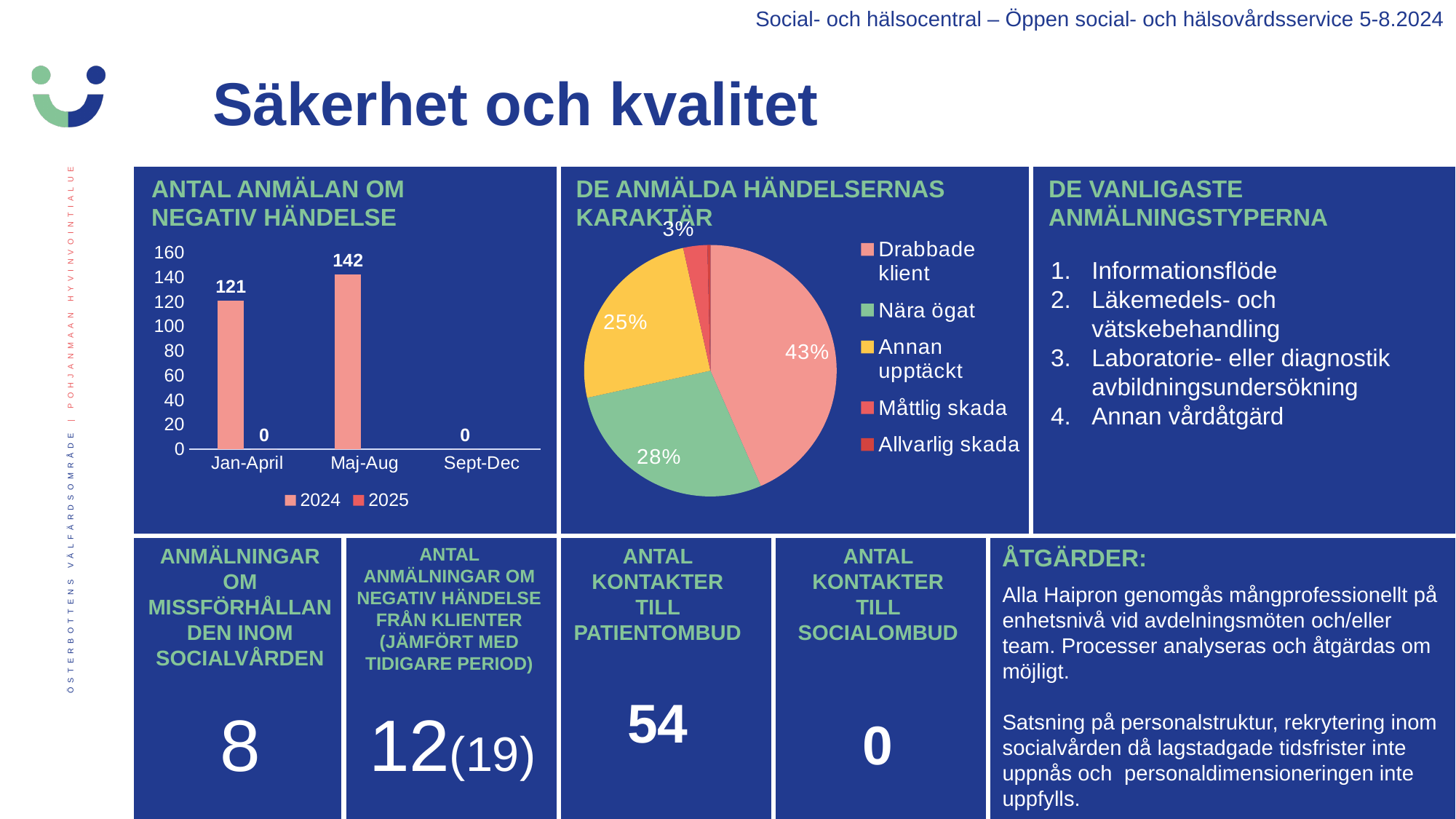
In the chart titled 'ANTAL ANMÄLAN OM NEGATIV HÄNDELSE', what is the difference between the 2024 values for Maj-Aug and Jan-April? 21 What kind of chart is 'ANTAL ANMÄLAN OM NEGATIV HÄNDELSE'? Bar chart In the chart titled 'ANTAL ANMÄLAN OM NEGATIV HÄNDELSE', how many series does the legend list? 2 In the chart titled 'DE ANMÄLDA HÄNDELSERNAS KARAKTÄR', what share is 'Drabbade klient'? 43% In the chart titled 'ANTAL ANMÄLAN OM NEGATIV HÄNDELSE', what is the 2024 value for Jan-April? 121 In the chart titled 'ANTAL ANMÄLAN OM NEGATIV HÄNDELSE', what is the 2024 value for Maj-Aug? 142 In the chart titled 'DE ANMÄLDA HÄNDELSERNAS KARAKTÄR', which is larger: 'Nära ögat' or 'Annan upptäckt'? Nära ögat In the chart titled 'DE ANMÄLDA HÄNDELSERNAS KARAKTÄR', how many categories does the legend list? 5 In the chart titled 'ANTAL ANMÄLAN OM NEGATIV HÄNDELSE', which period has the highest 2024 value? Maj-Aug In the chart titled 'DE ANMÄLDA HÄNDELSERNAS KARAKTÄR', what share is 'Annan upptäckt'? 25% In the chart titled 'ANTAL ANMÄLAN OM NEGATIV HÄNDELSE', how many periods are shown on the x axis? 3 In the chart titled 'DE ANMÄLDA HÄNDELSERNAS KARAKTÄR', which category has the largest slice? Drabbade klient